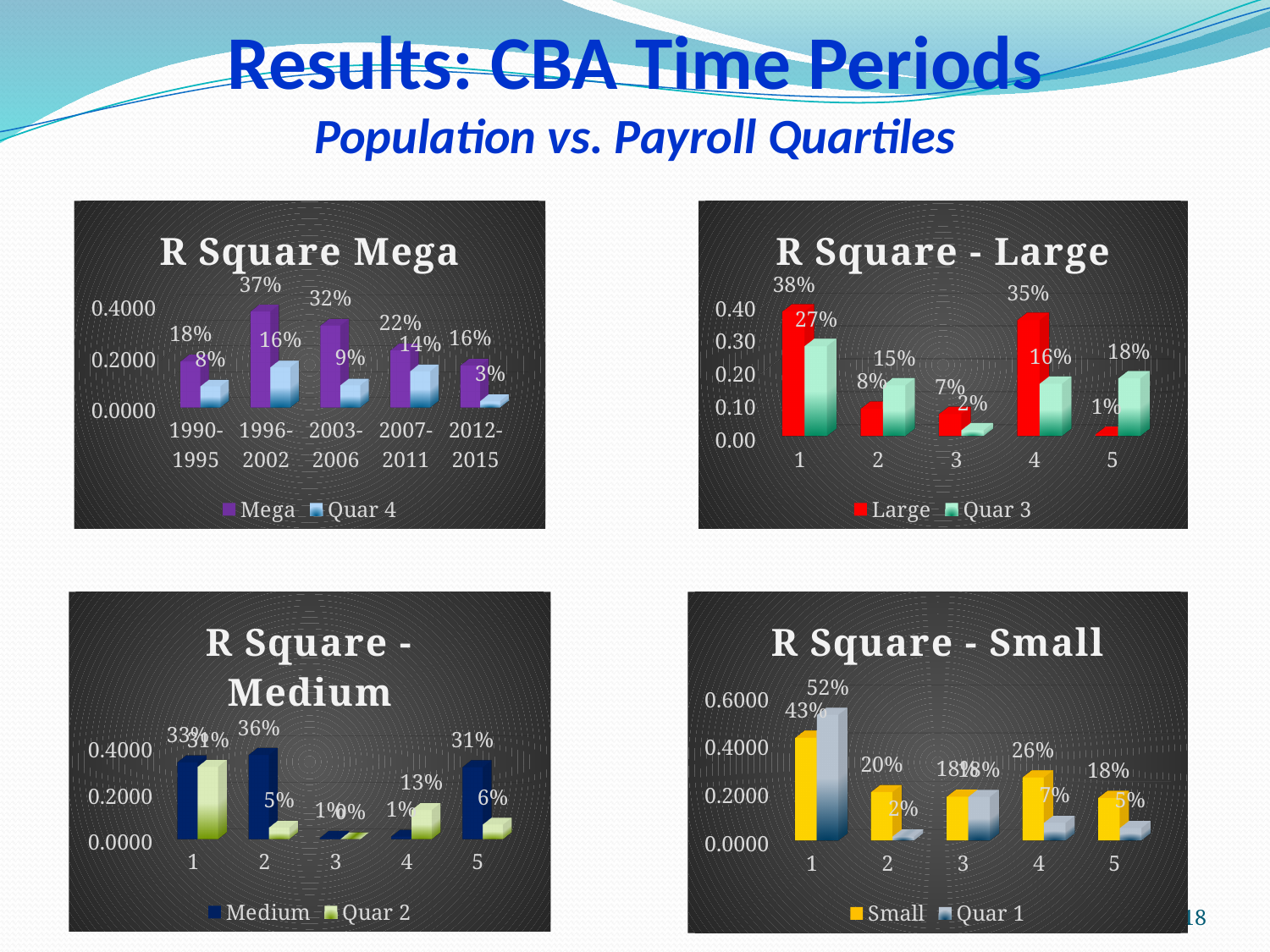
In the R Square - Large chart, what is the Large value for category 1? 38% In the R Square - Large chart, which category has the lowest Large value? 5 In the R Square Mega chart, what is the Mega value for 1996-2002? 37% In the R Square Mega chart, what is the Quar 4 value for 2012-2015? 3% In the R Square - Medium chart, what is the Medium value for category 2? 36% In the R Square Mega chart, which time period has the highest Mega value? 1996-2002 In the R Square Mega chart, how many time periods are shown on the x axis? 5 In the R Square - Small chart, what is the Quar 1 value for category 1? 52% In the R Square - Medium chart, which is larger for category 4, the Medium value or the Quar 2 value? Quar 2 In the R Square - Small chart, which category has the highest Small value? 1 What type of chart is the R Square - Small chart? Bar chart In the R Square - Large chart, what is the difference between the Large and Quar 3 values for category 4? 19%